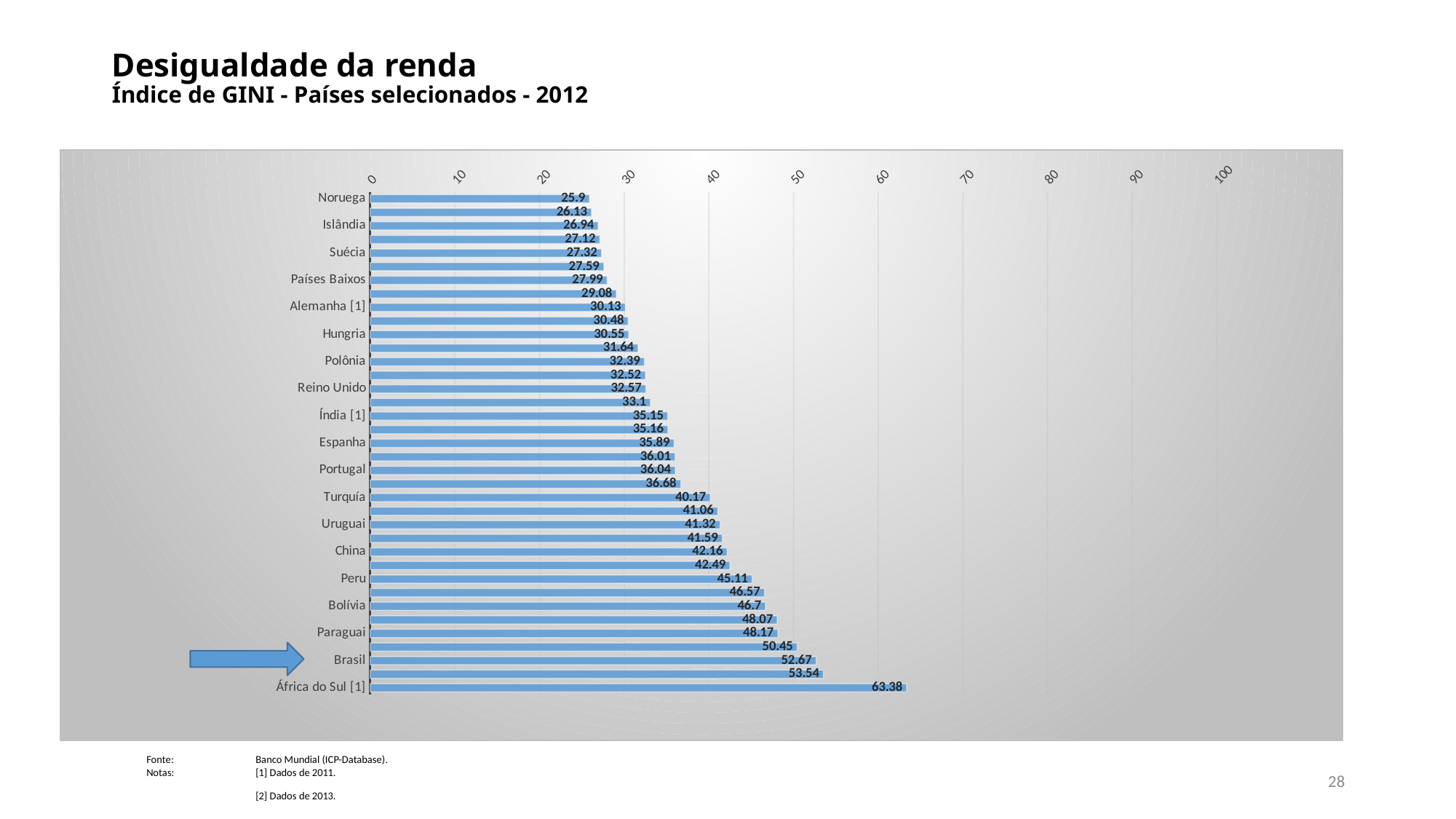
Which country does the blue arrow on the left of the chart point to? Brasil Do the bar values increase or decrease going from the top of the chart to the bottom? Increase Is the value for Paraguai greater or less than 50? less What is the GINI index value shown for Brasil? 52.67 What kind of chart is shown on the slide? Bar chart What is the value shown for China? 42.16 What is the value shown for Noruega? 25.9 Which country has the lowest GINI index on the chart? Noruega Which has a higher value, Peru or Uruguai? Peru What is the value shown for África do Sul [1]? 63.38 What is the difference between the values for Brasil and Noruega? 26.77 Which country has the highest GINI index on the chart? África do Sul [1]